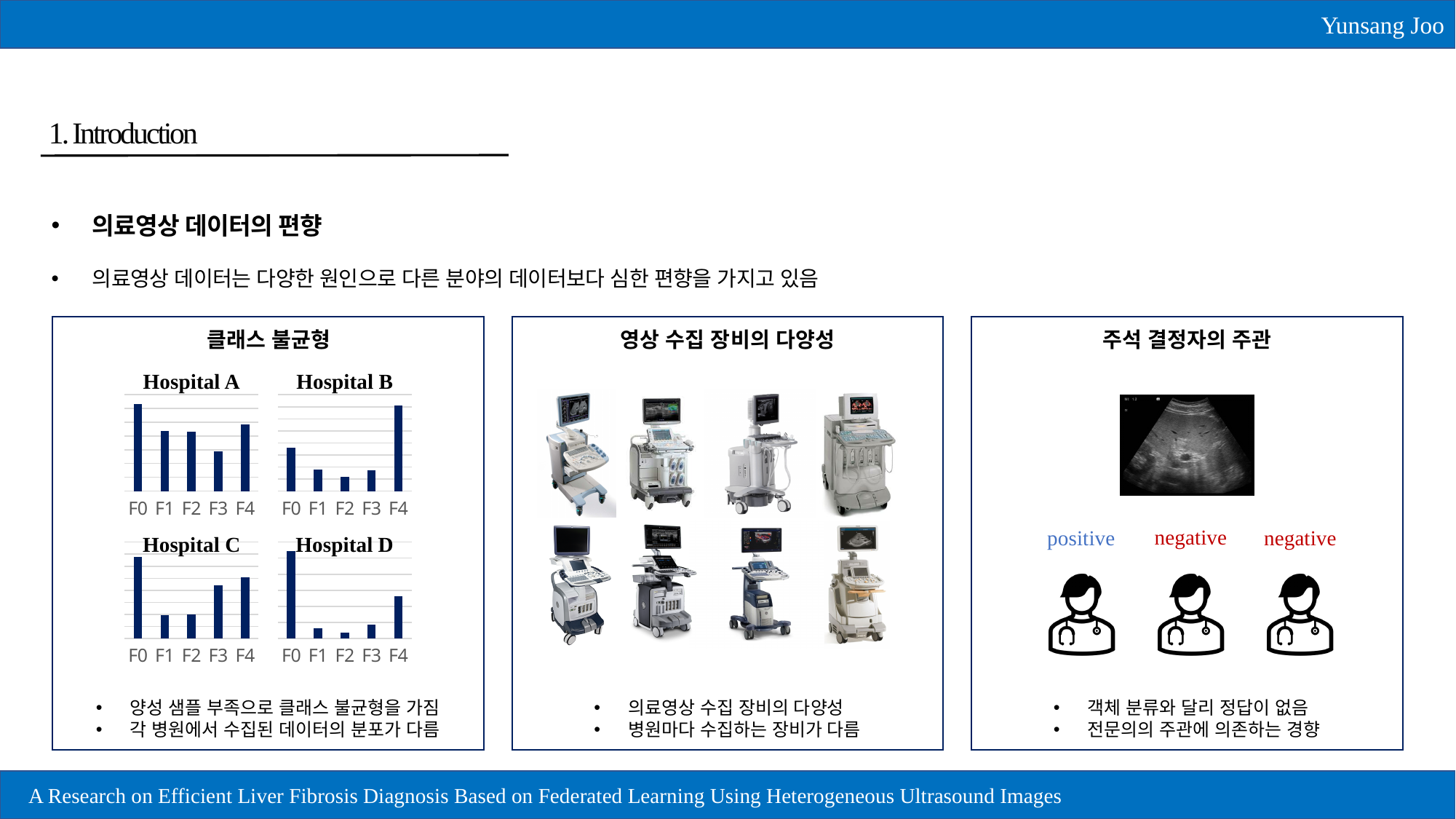
In the Hospital D chart, which category has the highest bar? F0 In the Hospital A chart, which category has the lowest bar? F3 In the Hospital A chart, what kind of chart is used? bar chart How many hospital bar charts are shown in the left panel titled 클래스 불균형? 4 In the Hospital B chart, which category has the lowest bar? F2 In the Hospital A chart, which category has the highest bar? F0 In the Hospital A chart, how many categories are shown on the x axis? 5 In the Hospital B chart, which is larger, the bar for F0 or the bar for F1? F0 In the Hospital D chart, which category has the lowest bar? F2 In the Hospital C chart, which category has the highest bar? F0 In the Hospital C chart, which is larger, the bar for F0 or the bar for F3? F0